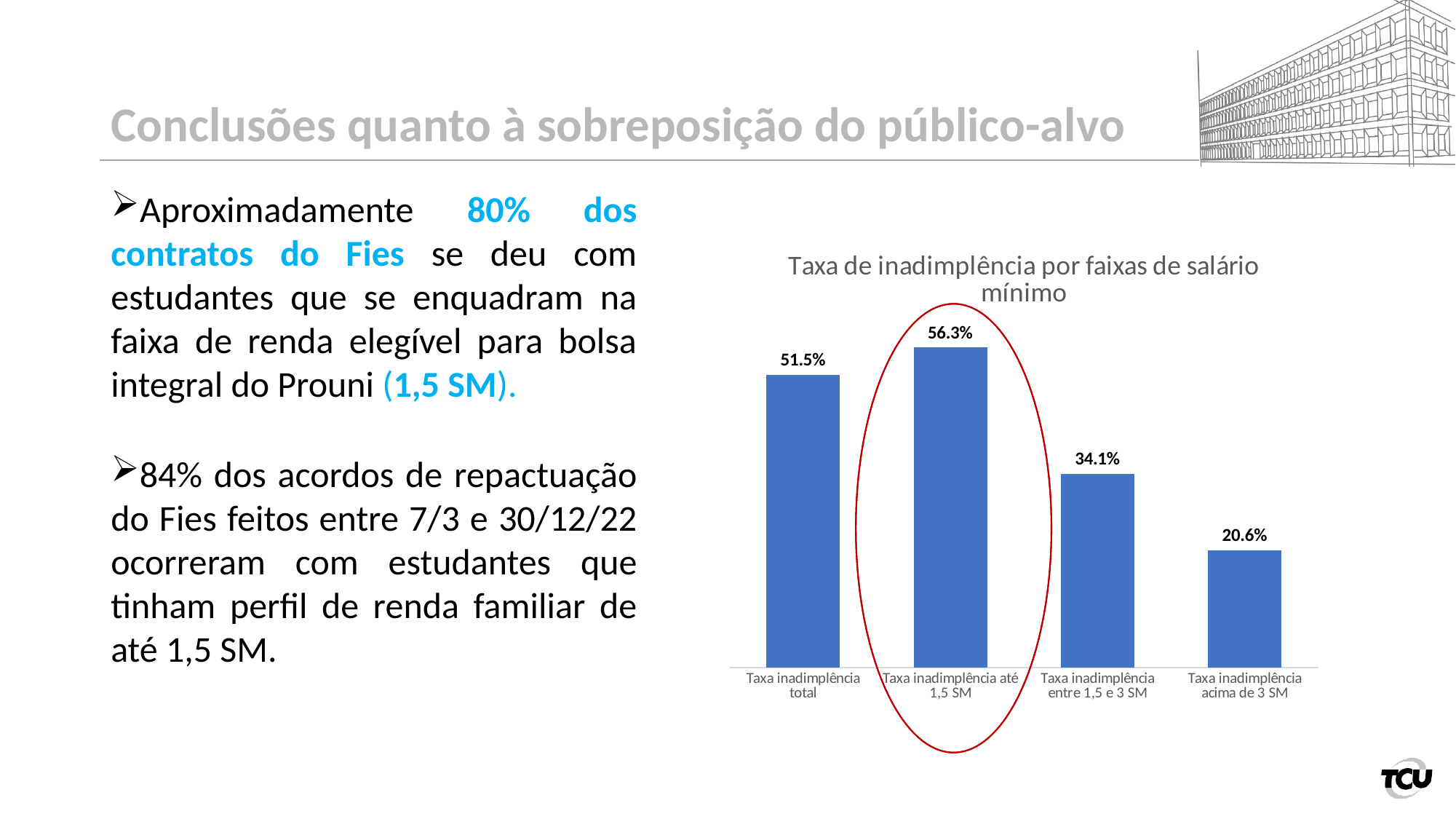
What is the value for 'Taxa inadimplência até 1,5 SM'? 56.3% What is the value for 'Taxa inadimplência entre 1,5 e 3 SM'? 34.1% What kind of chart is shown on the slide? Bar chart How many categories are shown in the chart? 4 What is the value for 'Taxa inadimplência acima de 3 SM'? 20.6% Which category has the highest value? Taxa inadimplência até 1,5 SM Which is larger: the value for 'Taxa inadimplência entre 1,5 e 3 SM' or 'Taxa inadimplência acima de 3 SM'? Taxa inadimplência entre 1,5 e 3 SM Which category has the lowest value? Taxa inadimplência acima de 3 SM What is the value for 'Taxa inadimplência total'? 51.5% What is the difference between the values for 'Taxa inadimplência até 1,5 SM' and 'Taxa inadimplência acima de 3 SM'? 35.7% What is the title of the chart? Taxa de inadimplência por faixas de salário mínimo What is the difference between the values for 'Taxa inadimplência total' and 'Taxa inadimplência entre 1,5 e 3 SM'? 17.4%